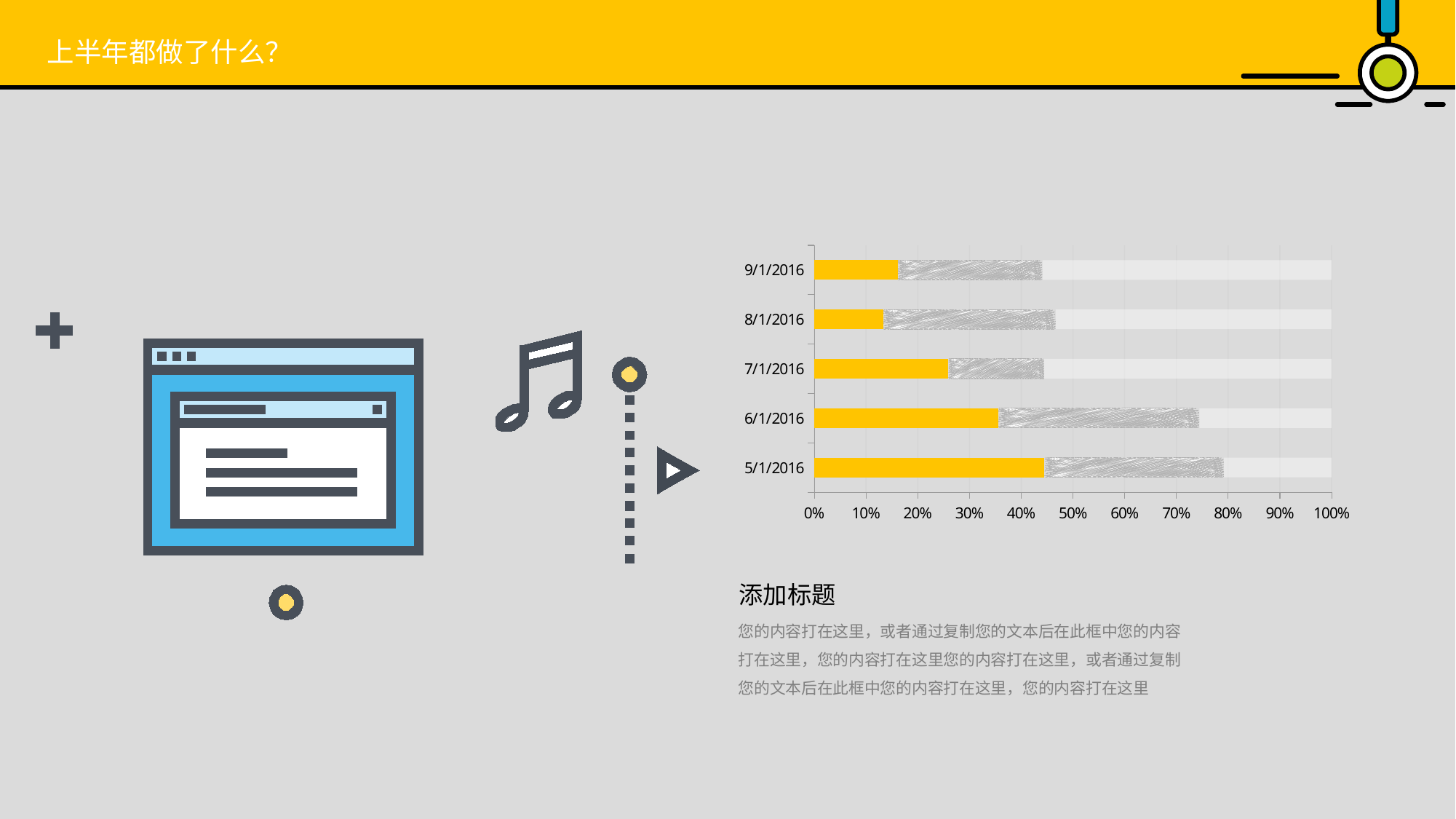
Is the yellow segment for 5/1/2016 greater or less than 40%? greater Which has the larger yellow segment, 5/1/2016 or 9/1/2016? 5/1/2016 Is the yellow segment for 7/1/2016 greater or less than 20%? greater Which has the larger yellow segment, 6/1/2016 or 7/1/2016? 6/1/2016 What kind of chart is shown on the slide? Bar chart Which date has the shortest yellow segment? 8/1/2016 Is the yellow segment for 6/1/2016 greater or less than 30%? greater What colour is the first (leftmost) segment of each bar? Yellow How many categories (dates) are plotted on the chart? 5 What is the highest value shown on the horizontal axis of the chart? 100% Which date has the longest yellow segment? 5/1/2016